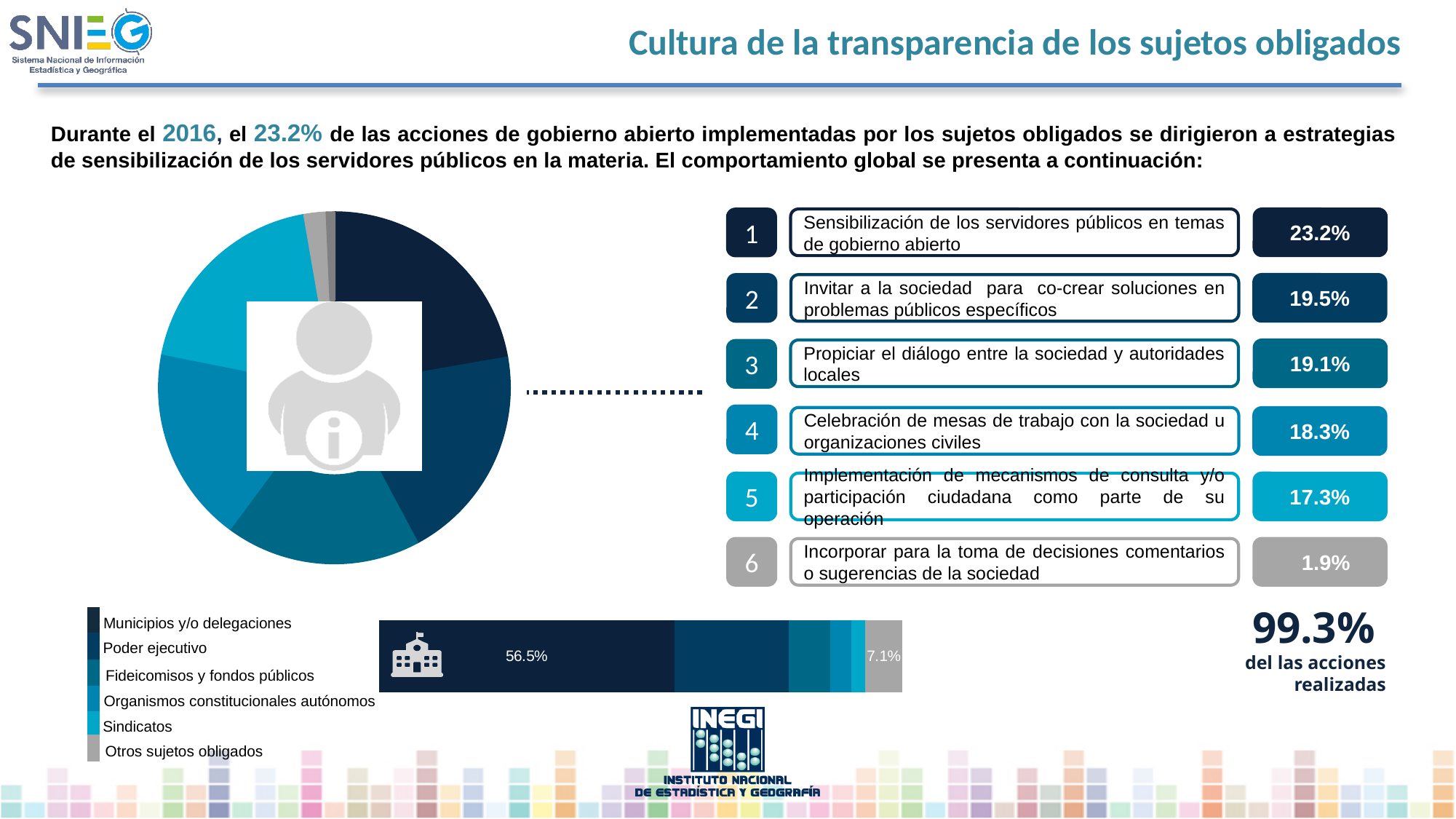
In the pie chart, which category has the largest share? Sensibilización de los servidores públicos en temas de gobierno abierto How many series does the legend of the stacked bar chart at the bottom list? 6 In the stacked bar chart at the bottom, what percentage is shown for 'Municipios y/o delegaciones'? 56.5% In the pie chart, what percentage is shown for 'Propiciar el diálogo entre la sociedad y autoridades locales'? 19.1% In the pie chart, what percentage is shown for 'Incorporar para la toma de decisiones comentarios o sugerencias de la sociedad'? 1.9% What kind of chart is the circular chart on the left of the slide? Doughnut chart In the stacked bar chart at the bottom, what percentage is shown for 'Otros sujetos obligados'? 7.1% In the pie chart, what share of open government actions corresponds to 'Sensibilización de los servidores públicos en temas de gobierno abierto'? 23.2% In the pie chart, what is the difference in percentage points between category 1 (23.2%) and category 5 (17.3%)? 5.9 How many categories does the pie chart have? 7 In the pie chart, which is larger: the share for 'Invitar a la sociedad para co-crear soluciones en problemas públicos específicos' or the share for 'Celebración de mesas de trabajo con la sociedad u organizaciones civiles'? Invitar a la sociedad para co-crear soluciones en problemas públicos específicos